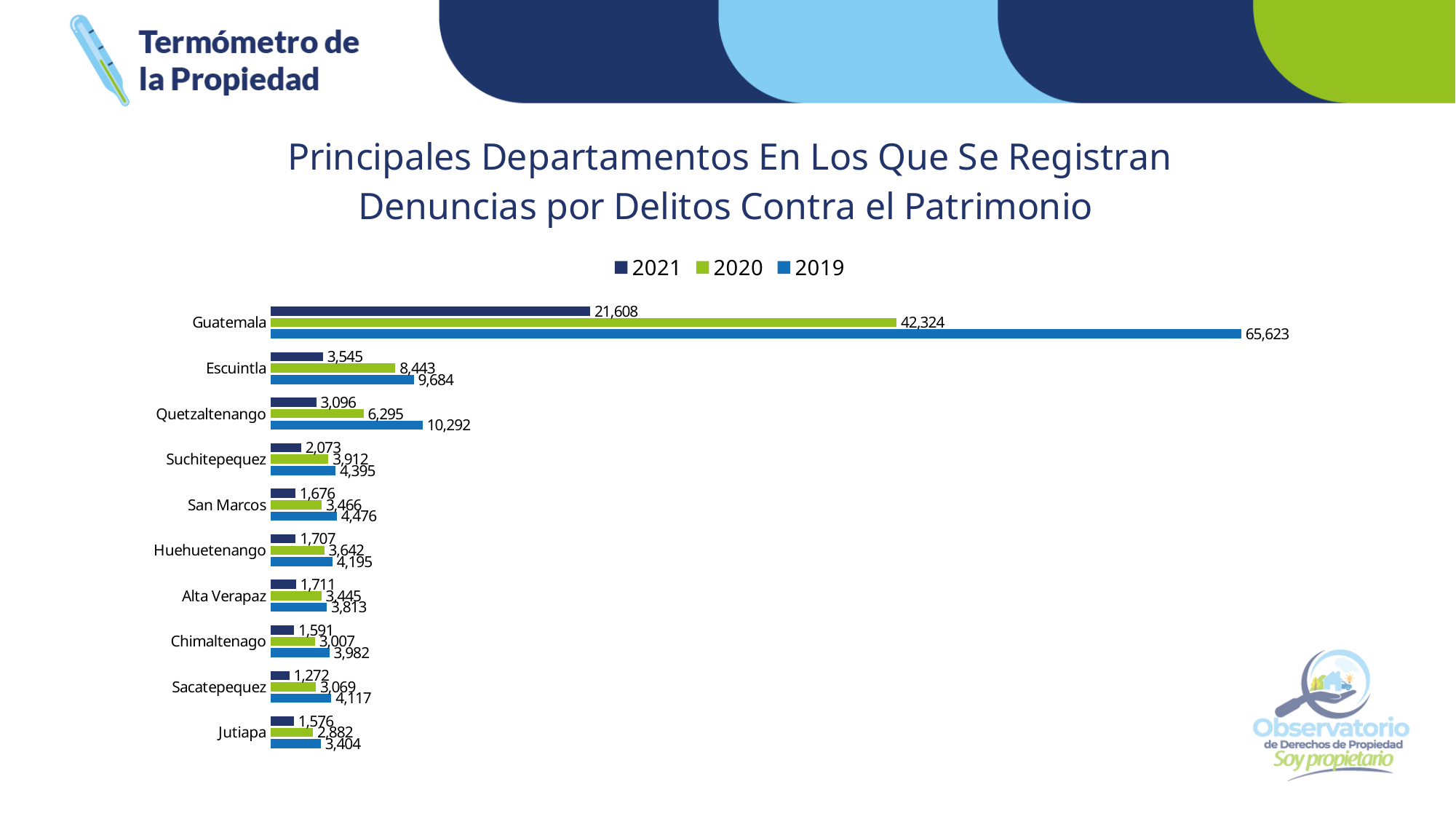
What is the 2020 value for Quetzaltenango? 6,295 How many series does the legend list? 3 What type of chart is shown on the slide? bar chart What is the 2021 value for Sacatepequez? 1,272 What is the 2019 value for Guatemala? 65,623 Which department has the highest 2020 value? Guatemala For Guatemala, do the values rise or fall from 2019 to 2021? fall What is the difference between the 2019 and 2021 values for Guatemala? 44,015 How many departments are shown on the chart? 10 Which year is represented by the green bars in the legend? 2020 Which is larger, the 2019 value for Quetzaltenango or the 2019 value for Escuintla? Quetzaltenango Which department has the lowest 2019 value? Jutiapa